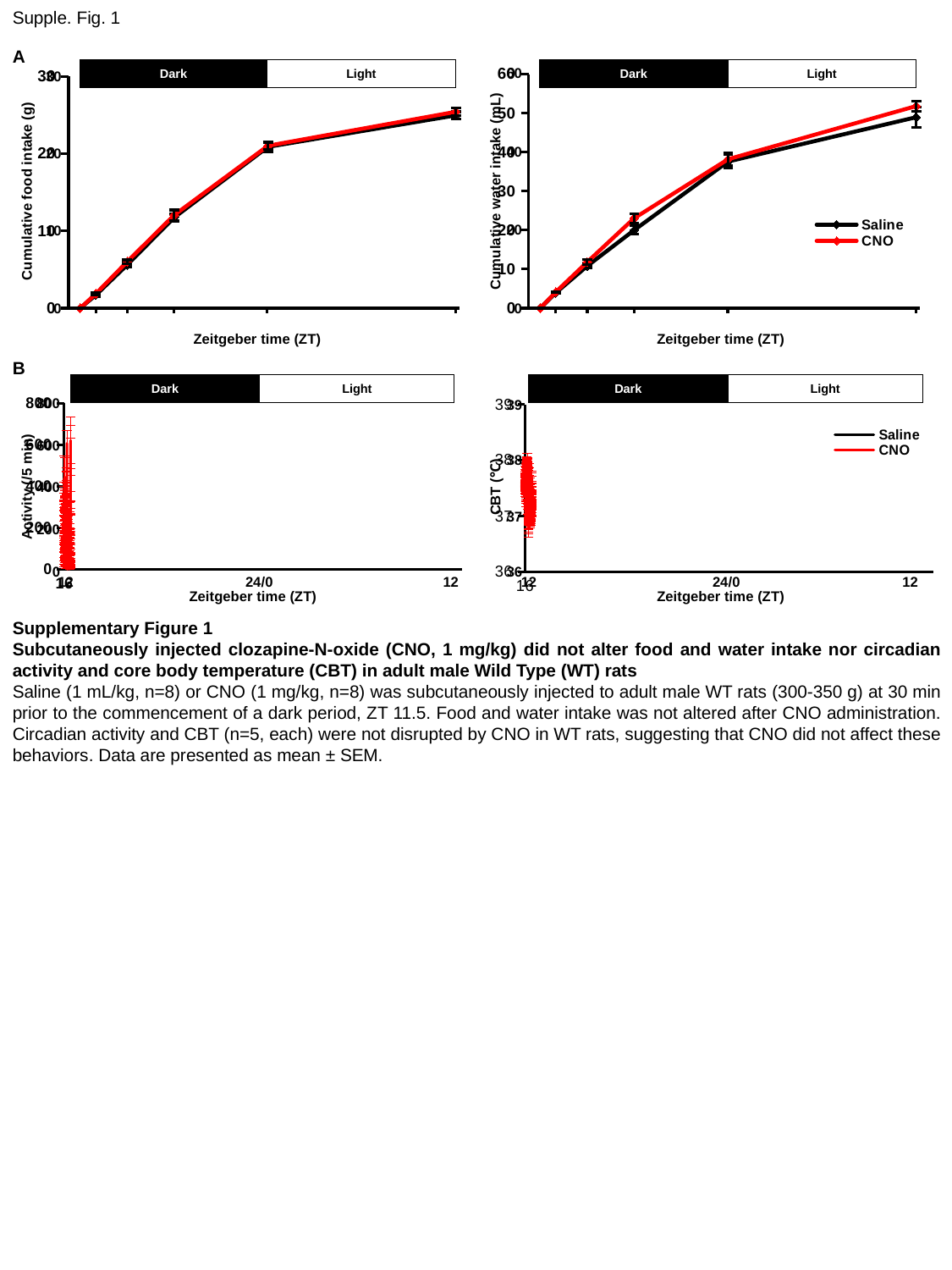
In the top-left cumulative food intake chart, do the values rise or fall along the x axis? rise In the top-right cumulative water intake chart, is the first non-zero value of the Saline series greater or less than 20? less What kind of chart is the bottom-right CBT chart? line chart What is the y-axis label of the top-left chart? Cumulative food intake (g) How many series does the legend list for the top-right cumulative water intake chart? 2 How many series does the legend list for the bottom-right CBT chart? 2 In the bottom-right CBT chart, are the plotted values greater or less than 36? greater In the top-right cumulative water intake chart, do the values rise or fall along the x axis? rise In the top-right cumulative water intake chart, is the final value of the CNO series greater or less than 40? greater In the top-right cumulative water intake chart, which series is drawn in red? CNO What kind of chart is the top-left chart showing cumulative food intake? line chart